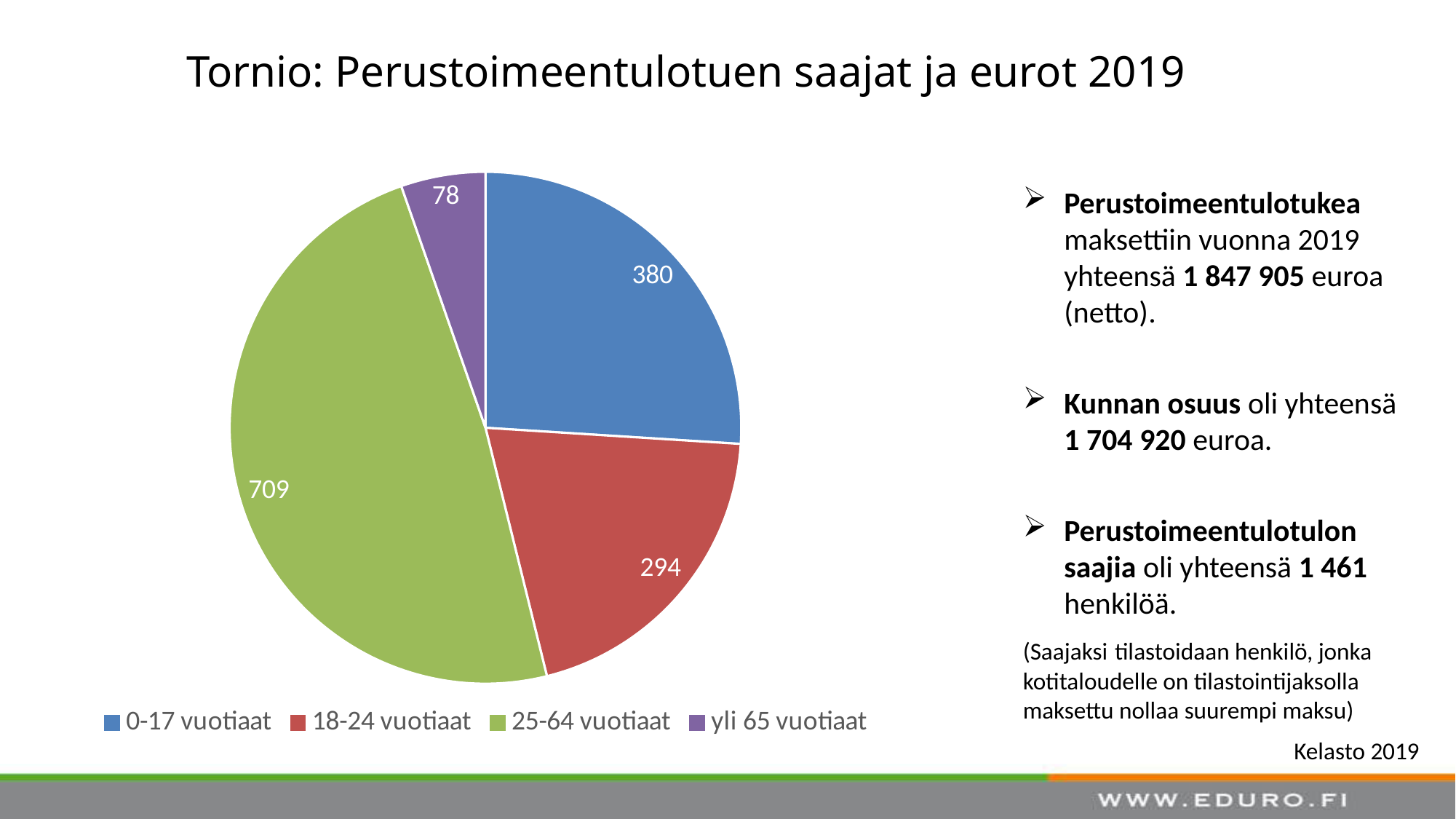
What is the value for the 0-17 vuotiaat slice? 380 What colour is the 25-64 vuotiaat slice? green What is the total of all the slice values in the pie chart? 1461 What is the difference between the values for 25-64 vuotiaat and 0-17 vuotiaat? 329 Which is larger, the value for 0-17 vuotiaat or for 18-24 vuotiaat? 0-17 vuotiaat Which age group has the smallest slice of the pie? yli 65 vuotiaat Which age group has the largest slice of the pie? 25-64 vuotiaat What is the value for the 18-24 vuotiaat slice? 294 What type of chart is shown on the slide? pie chart How many slices does the pie chart have? 4 What is the value for the yli 65 vuotiaat slice? 78 What is the value for the 25-64 vuotiaat slice? 709